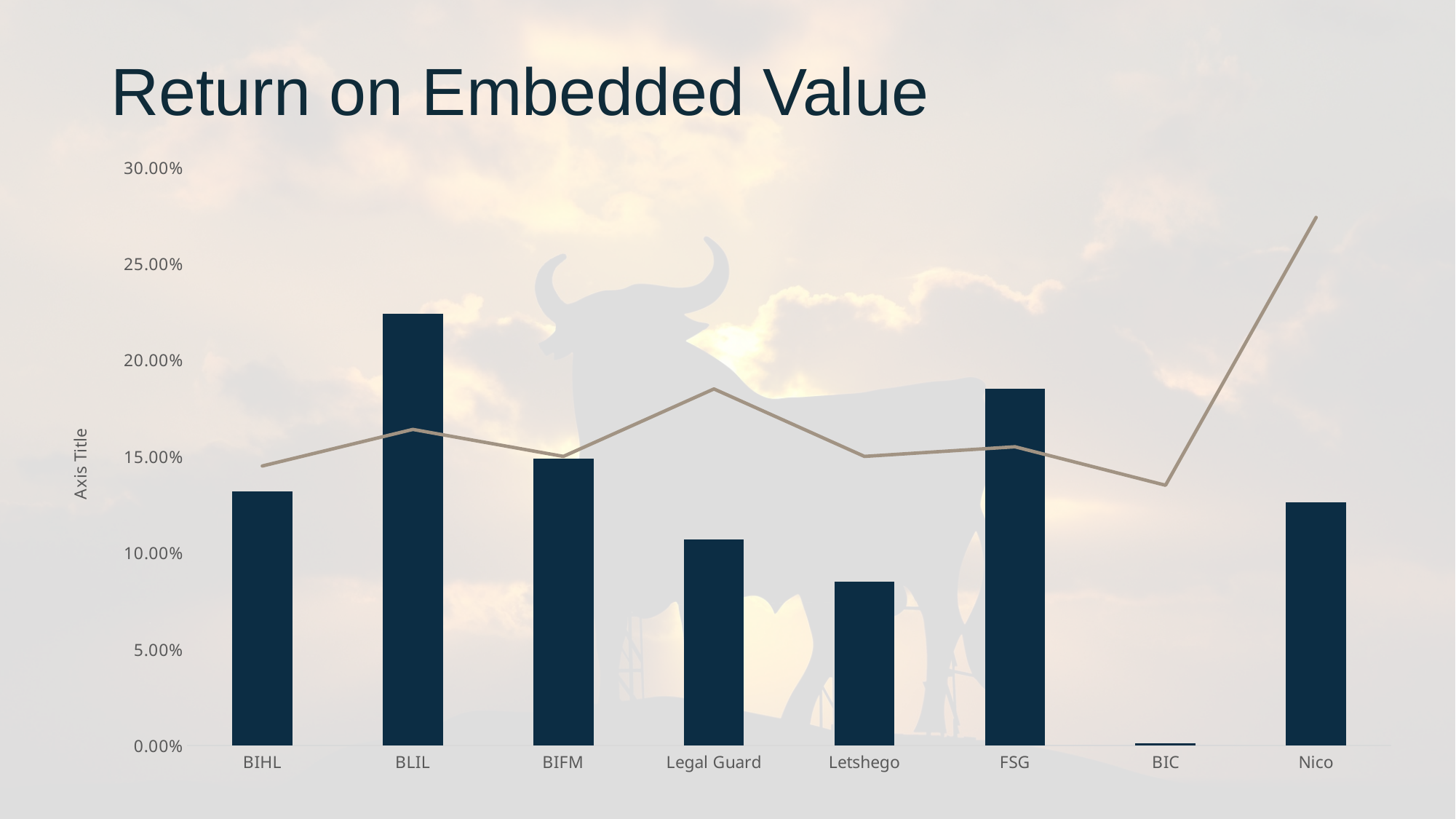
What is the title of the chart? Return on Embedded Value Is the bar value for Nico greater or less than 15.00%? less Which has the taller bar, BLIL or FSG? BLIL Which category has the tallest bar? BLIL Which category has the shortest bar? BIC Is the bar value for BLIL greater or less than 20.00%? greater Which has the taller bar, Legal Guard or Letshego? Legal Guard At which category does the line series reach its highest point? Nico What kind of chart is shown on the slide? bar chart with a line overlay How many categories are shown on the x axis? 8 Is the bar value for Letshego greater or less than 10.00%? less